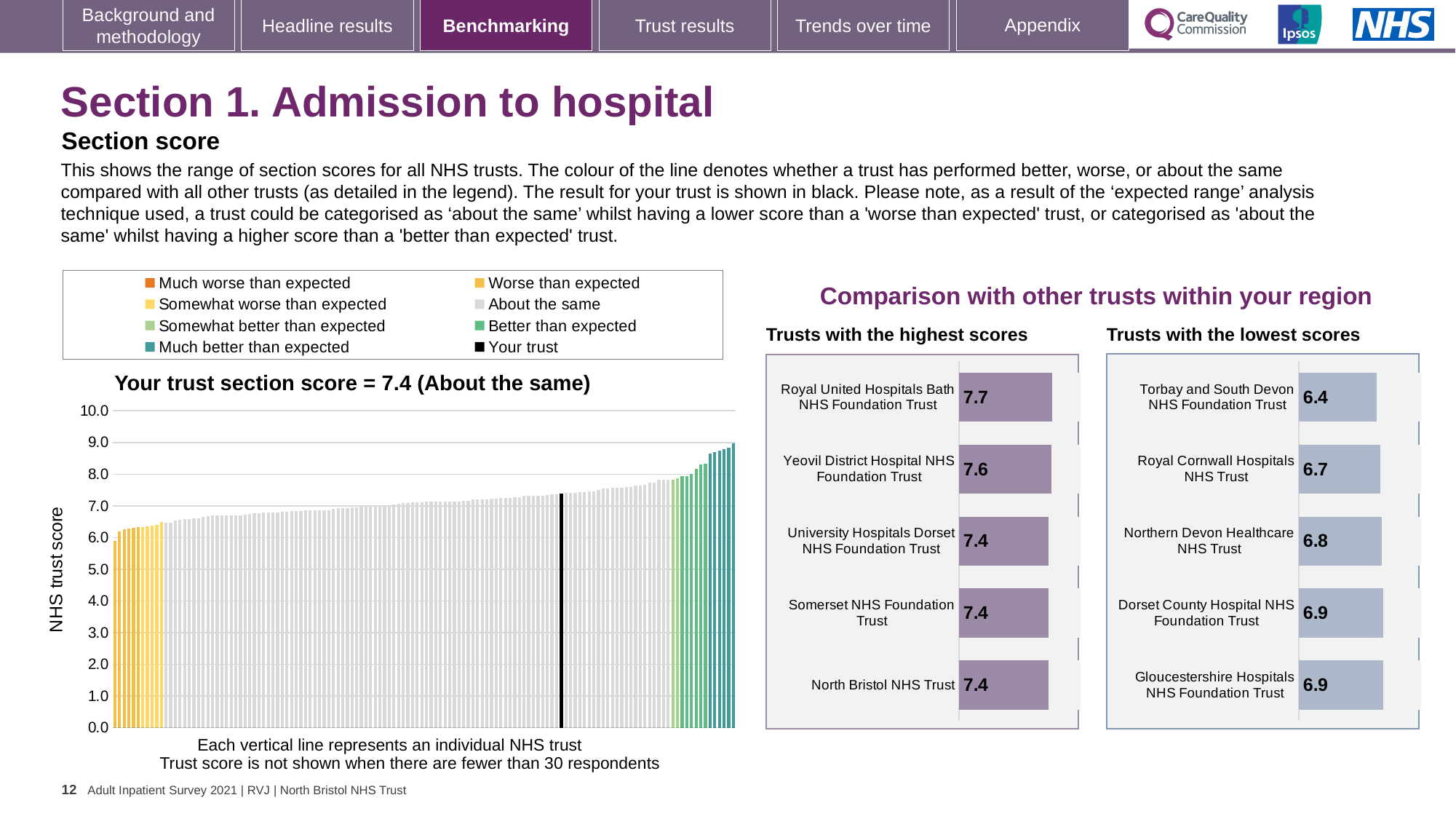
In the 'Trusts with the highest scores' chart, which trust has the highest score? Royal United Hospitals Bath NHS Foundation Trust How many trusts are listed in the 'Trusts with the highest scores' chart? 5 In the 'Trusts with the lowest scores' chart, what is the score for Northern Devon Healthcare NHS Trust? 6.8 In the main chart titled 'Your trust section score', what is the section score for your trust? 7.4 In the 'Trusts with the lowest scores' chart, which has the higher score: Royal Cornwall Hospitals NHS Trust or Northern Devon Healthcare NHS Trust? Northern Devon Healthcare NHS Trust In the 'Trusts with the highest scores' chart, what is the score for Royal United Hospitals Bath NHS Foundation Trust? 7.7 In the main chart titled 'Your trust section score', do the bar values rise or fall from left to right along the x axis? rise In the 'Trusts with the lowest scores' chart, which trust has the lowest score? Torbay and South Devon NHS Foundation Trust In the 'Trusts with the lowest scores' chart, what is the difference between the scores of Royal Cornwall Hospitals NHS Trust and Torbay and South Devon NHS Foundation Trust? 0.3 In the 'Trusts with the lowest scores' chart, what is the score for Torbay and South Devon NHS Foundation Trust? 6.4 In the 'Trusts with the highest scores' chart, what is the difference between the scores of Royal United Hospitals Bath NHS Foundation Trust and Yeovil District Hospital NHS Foundation Trust? 0.1 In the 'Trusts with the highest scores' chart, what is the score for Yeovil District Hospital NHS Foundation Trust? 7.6